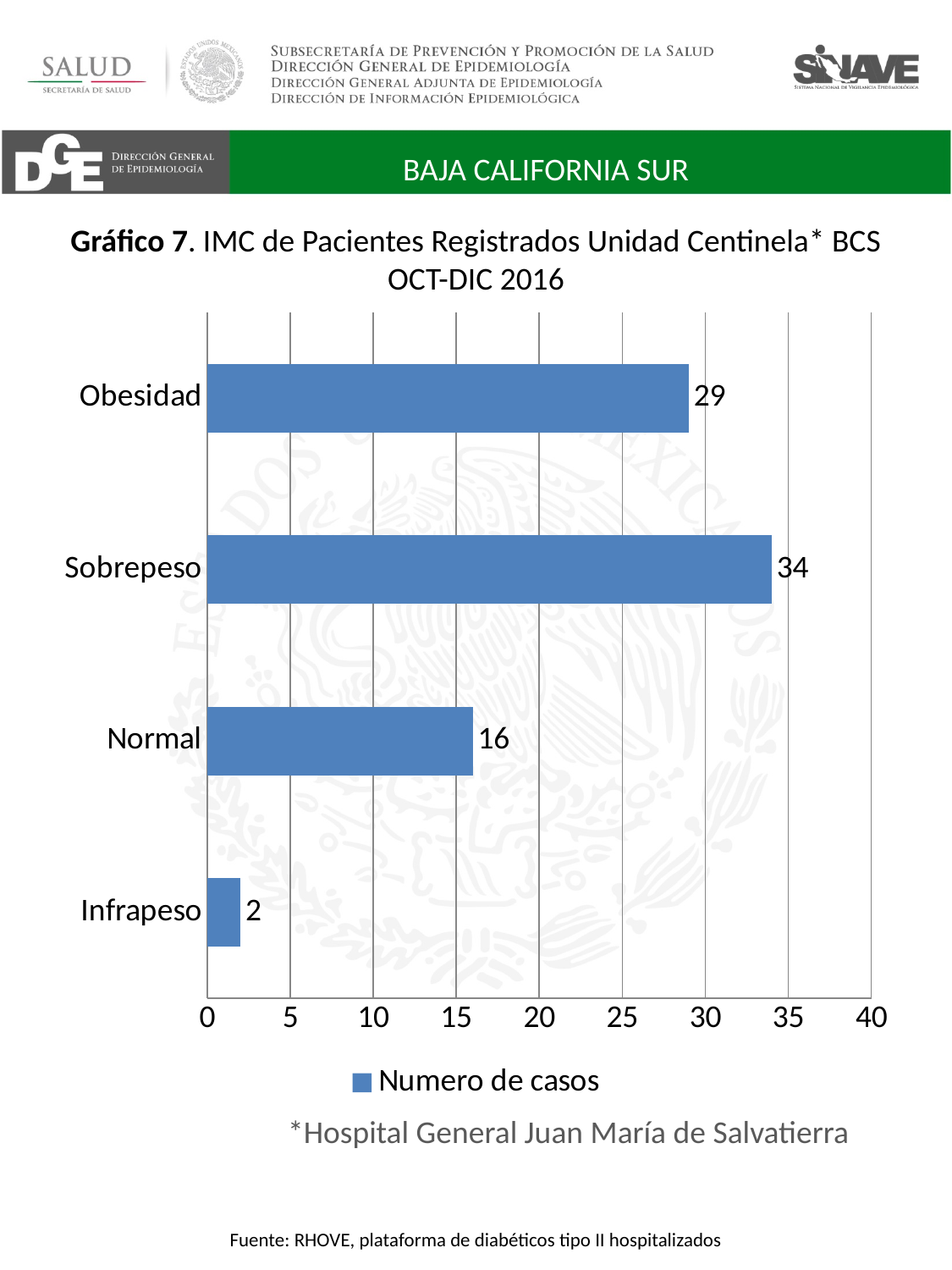
Which category has the lowest number of cases? Infrapeso How many categories are shown in the chart? 4 Is the value for Normal greater or less than 20? less What is the value for Obesidad? 29 What is the value for Sobrepeso? 34 What is the value for Infrapeso? 2 Which is larger, the value for Normal or the value for Obesidad? Obesidad What is the difference between the values for Sobrepeso and Obesidad? 5 What series name does the legend show? Numero de casos What is the value for Normal? 16 Which category has the highest number of cases? Sobrepeso What kind of chart is shown on the slide? bar chart